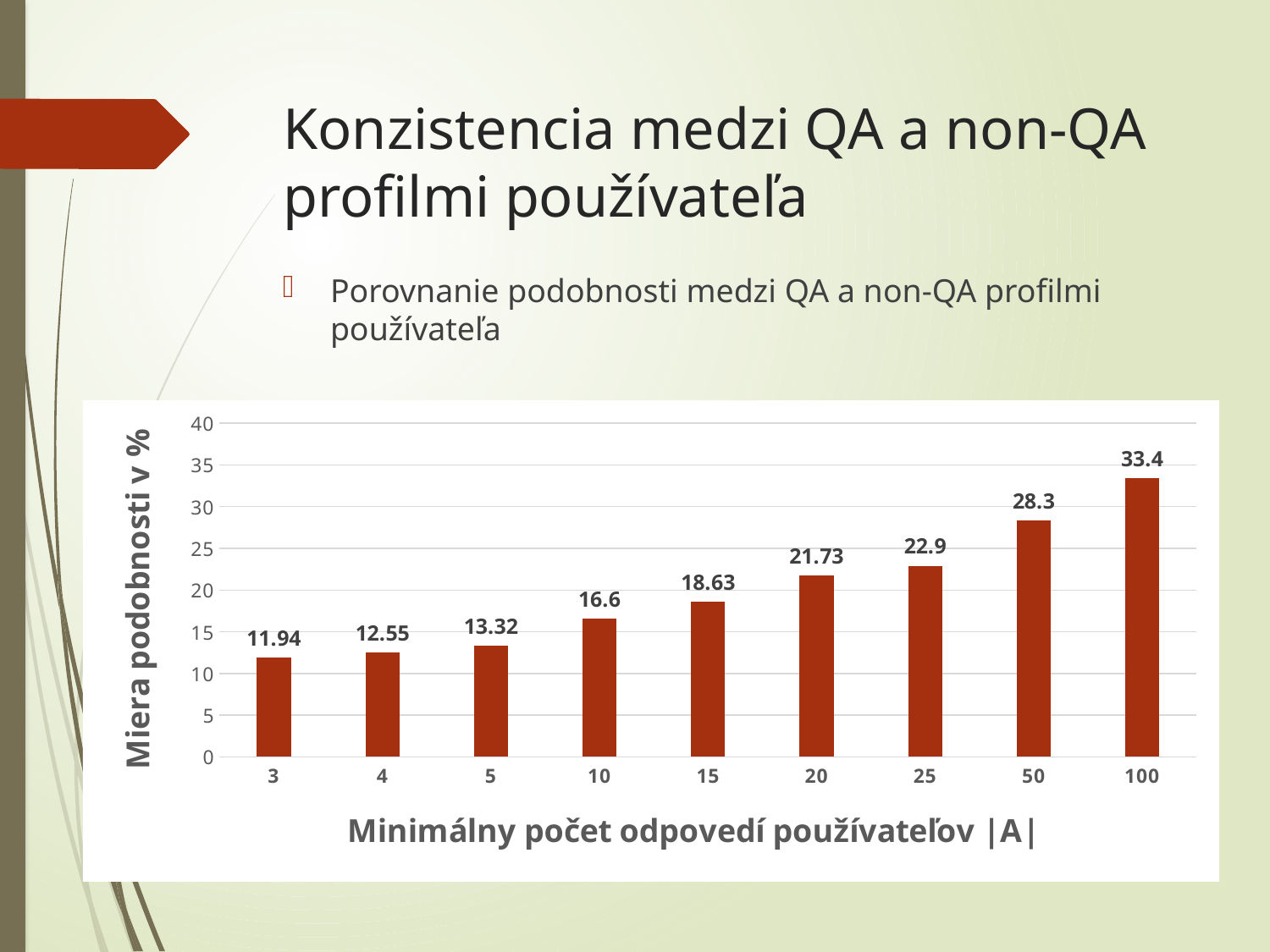
Is the value for category 15 greater or less than 20? less Do the values rise or fall as the minimum answer count increases along the x axis? rise What is the similarity rate (Miera podobnosti v %) for a minimum answer count of 10? 16.6 Which is larger, the value for category 25 or the value for category 20? 25 What is the value shown for the category 50? 28.3 What is the value shown for the category 3? 11.94 What kind of chart is shown on the slide? bar chart How many categories are shown on the x axis? 9 What is the difference between the values for categories 20 and 15? 3.1 Which minimum answer count category has the lowest similarity rate? 3 What is the difference between the values for categories 100 and 50? 5.1 Which minimum answer count category has the highest similarity rate? 100